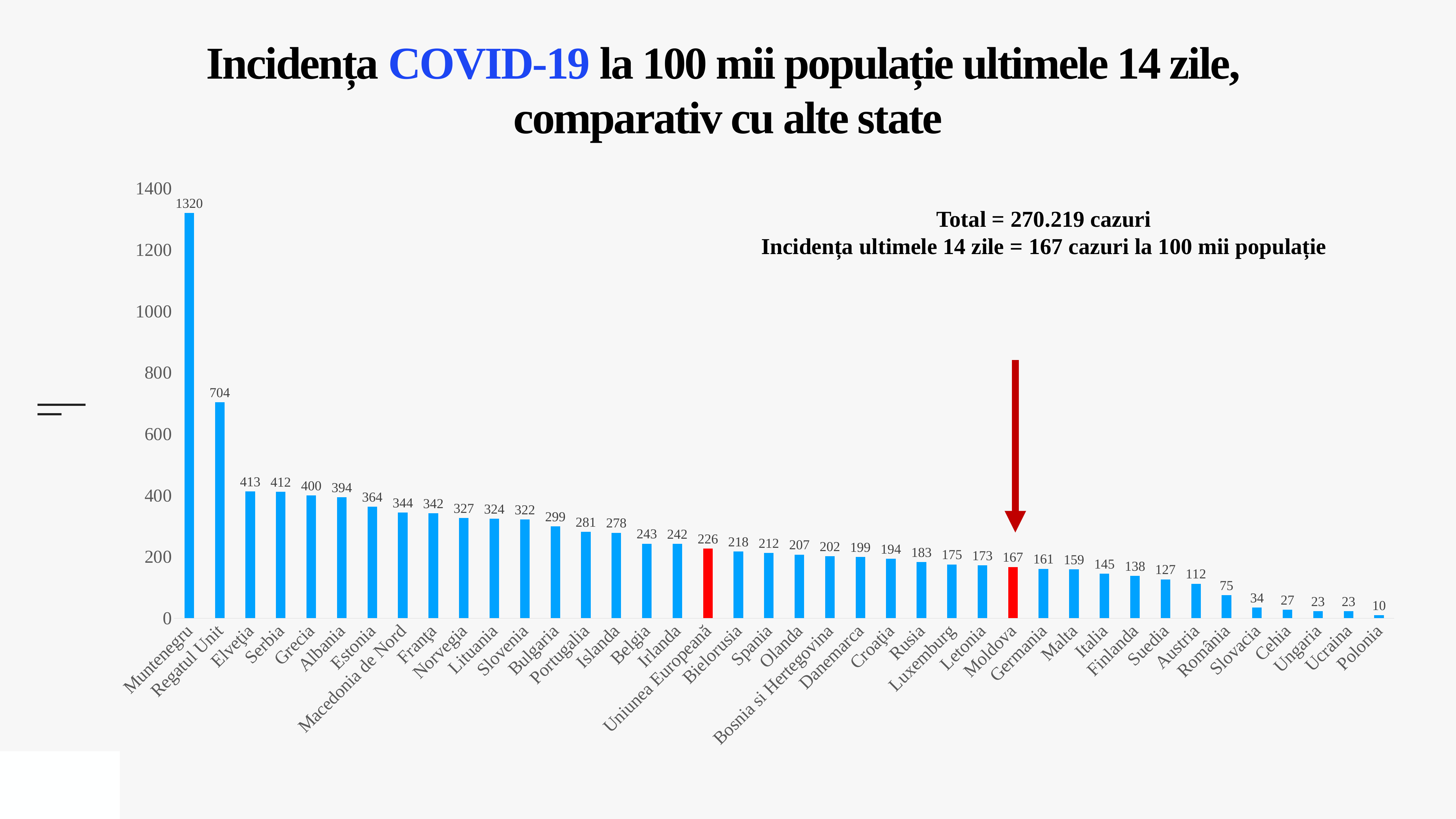
What is the value for România? 75 What is the difference between the values for Uniunea Europeană and Moldova? 59 What is the difference between the values for Muntenegru and Regatul Unit? 616 Which country has the lowest value? Polonia What is the value for Uniunea Europeană? 226 Which two bars are coloured red instead of blue? Uniunea Europeană and Moldova How many countries or regions are shown on the chart? 40 What is the value for Moldova? 167 Which country has the highest value? Muntenegru What is the value for Regatul Unit? 704 Which has a larger value, Germania or Italia? Germania What kind of chart is shown on the slide? bar chart